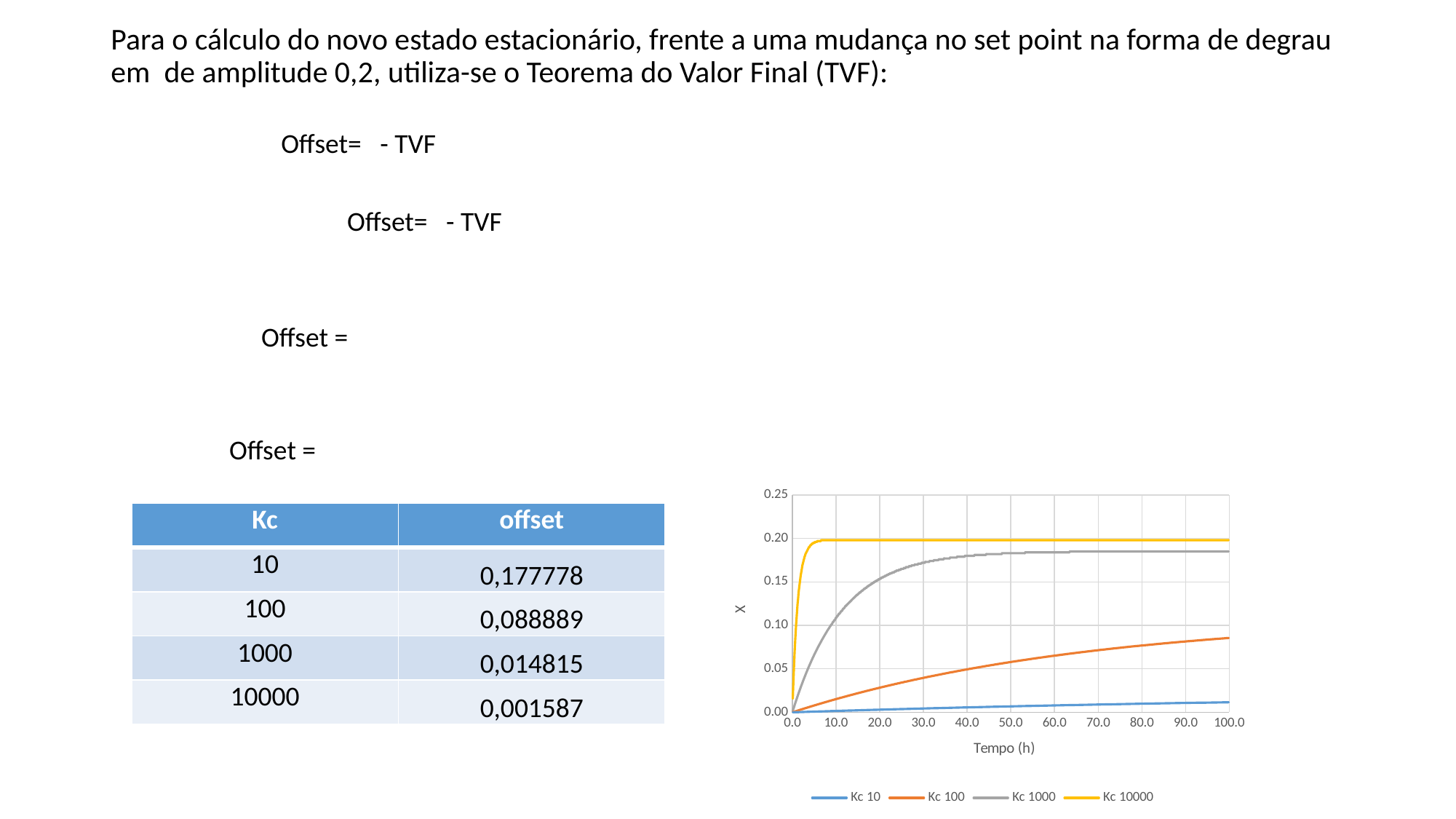
Is the value of the Kc 10000 series at 100.0 h greater or less than 0.15? greater Is the value of the Kc 10 series at 100.0 h greater or less than 0.05? less Does the Kc 100 series rise or fall as time increases along the x axis? rise Which series reaches the highest value on the chart? Kc 10000 What is the title of the x axis of the chart? Tempo (h) Is the value of the Kc 100 series at 100.0 h greater or less than 0.10? less Which series has the lowest values on the chart? Kc 10 What kind of chart is shown on the slide? line chart How many tick labels are shown on the x axis of the chart? 11 How many series does the chart legend list? 4 What are the series names listed in the chart legend? Kc 10, Kc 100, Kc 1000, Kc 10000 At 50.0 h, which series has the larger value, Kc 1000 or Kc 100? Kc 1000